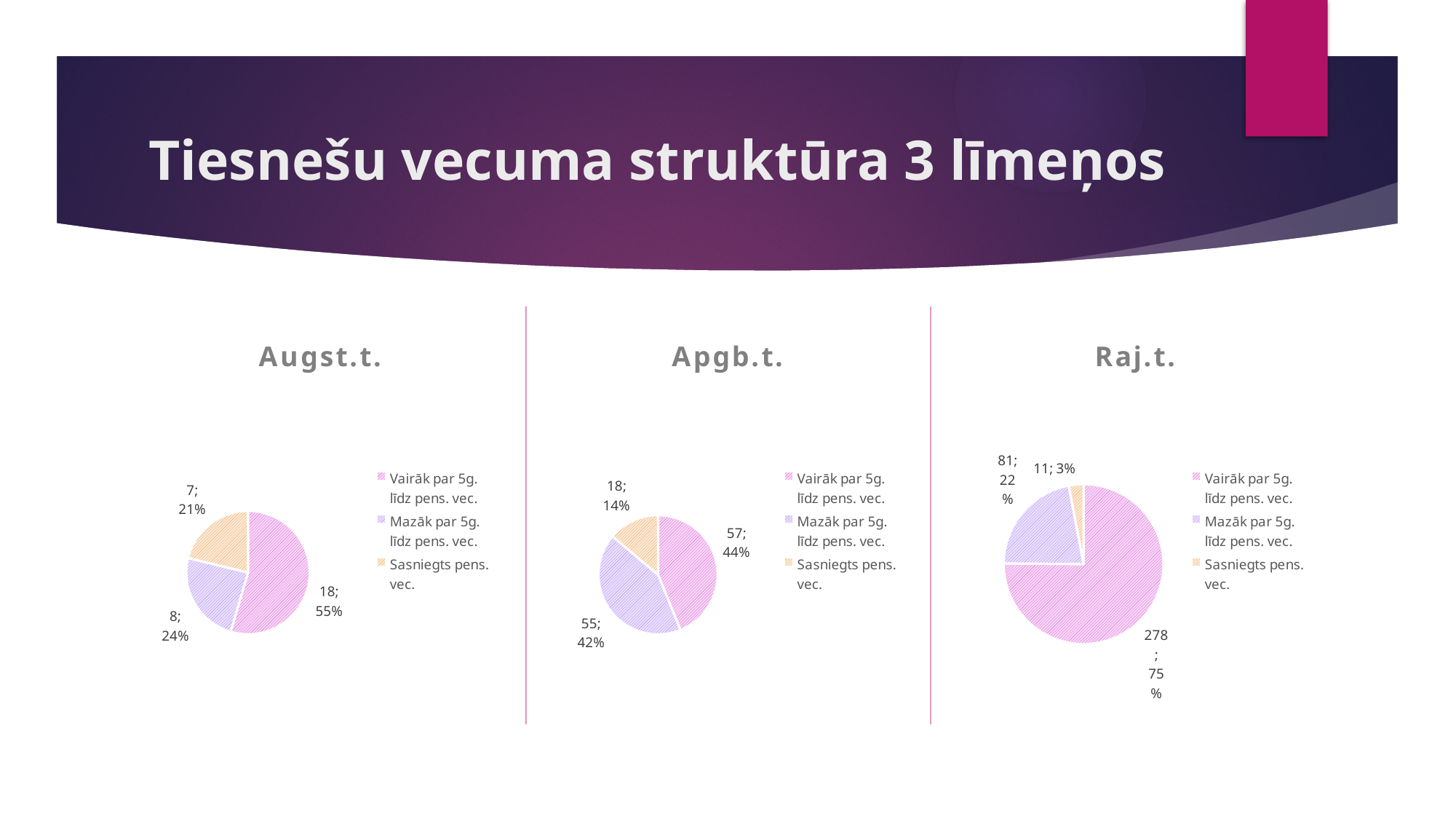
In the Raj.t. chart, what value is shown for 'Vairāk par 5g. līdz pens. vec.'? 278; 75% What kind of chart is used for the Augst.t. data? pie chart How many pie charts are shown on the slide? 3 In the Raj.t. chart, what is the difference between the counts for 'Mazāk par 5g. līdz pens. vec.' and 'Sasniegts pens. vec.'? 70 In the Apgb.t. chart, what is the difference between the counts for 'Vairāk par 5g. līdz pens. vec.' and 'Mazāk par 5g. līdz pens. vec.'? 2 How many categories does the legend of the Augst.t. chart list? 3 In the Raj.t. chart, what share of the pie does 'Sasniegts pens. vec.' have? 3% In the Apgb.t. chart, which category has the smallest slice? Sasniegts pens. vec. In the Apgb.t. chart, what value is shown for 'Mazāk par 5g. līdz pens. vec.'? 55; 42% In the Augst.t. chart, what share of the pie does 'Sasniegts pens. vec.' have? 21% In the Raj.t. chart, which category has the largest slice? Vairāk par 5g. līdz pens. vec. In the Augst.t. chart, what value is shown for 'Vairāk par 5g. līdz pens. vec.'? 18; 55%